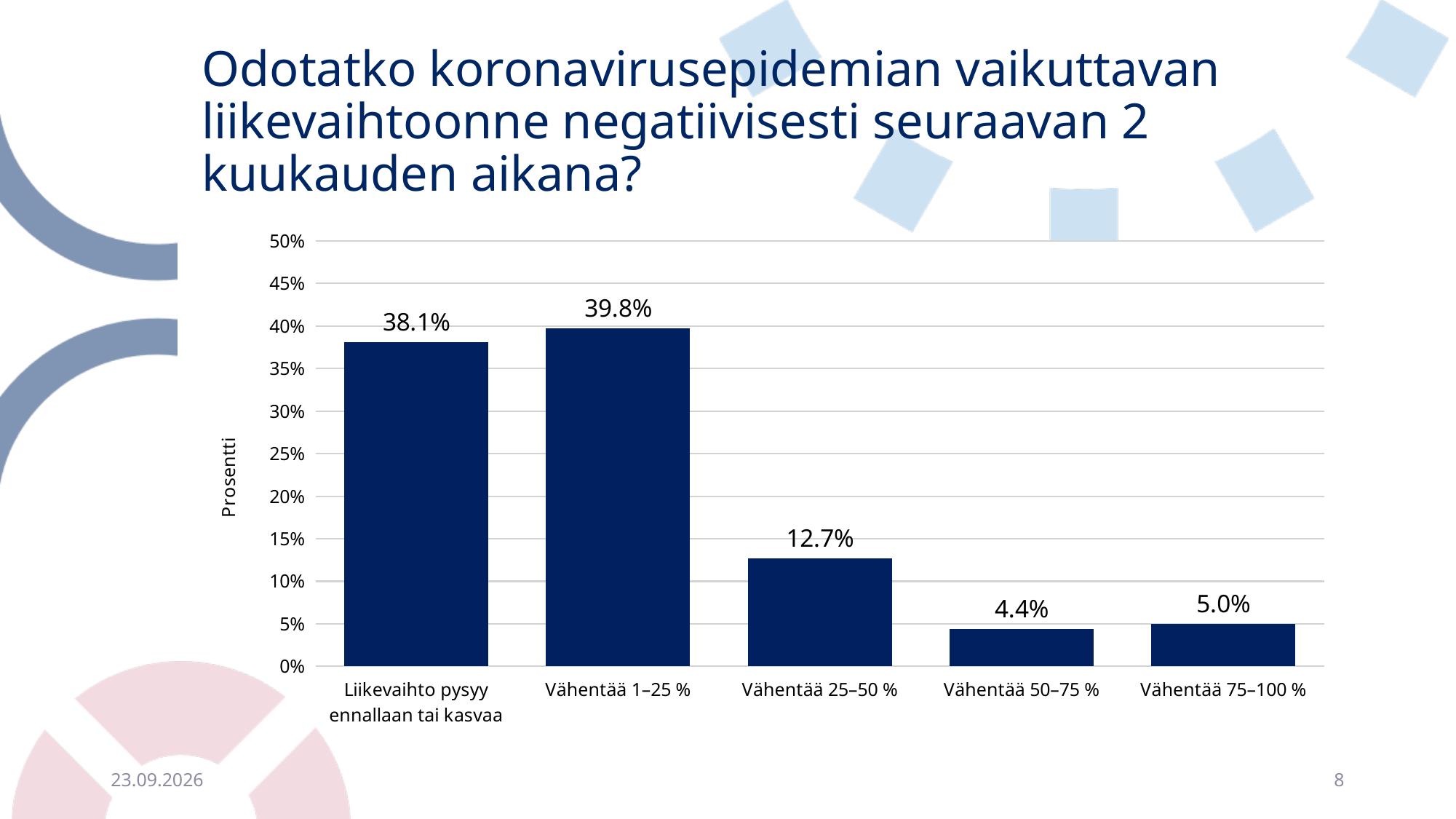
What is the value for "Liikevaihto pysyy ennallaan tai kasvaa"? 38.1% Which is larger, the value for "Vähentää 75–100 %" or the value for "Vähentää 50–75 %"? Vähentää 75–100 % What is the value for "Vähentää 1–25 %"? 39.8% Which category has the highest value? Vähentää 1–25 % What is the label of the vertical axis? Prosentti What kind of chart is shown on the slide? bar chart What is the value for "Vähentää 25–50 %"? 12.7% What is the value for "Vähentää 50–75 %"? 4.4% How many categories are shown on the x axis? 5 Is the value for "Vähentää 25–50 %" greater or less than 10%? greater Which category has the lowest value? Vähentää 50–75 % What is the difference between the values for "Vähentää 1–25 %" and "Liikevaihto pysyy ennallaan tai kasvaa"? 1.7 percentage points